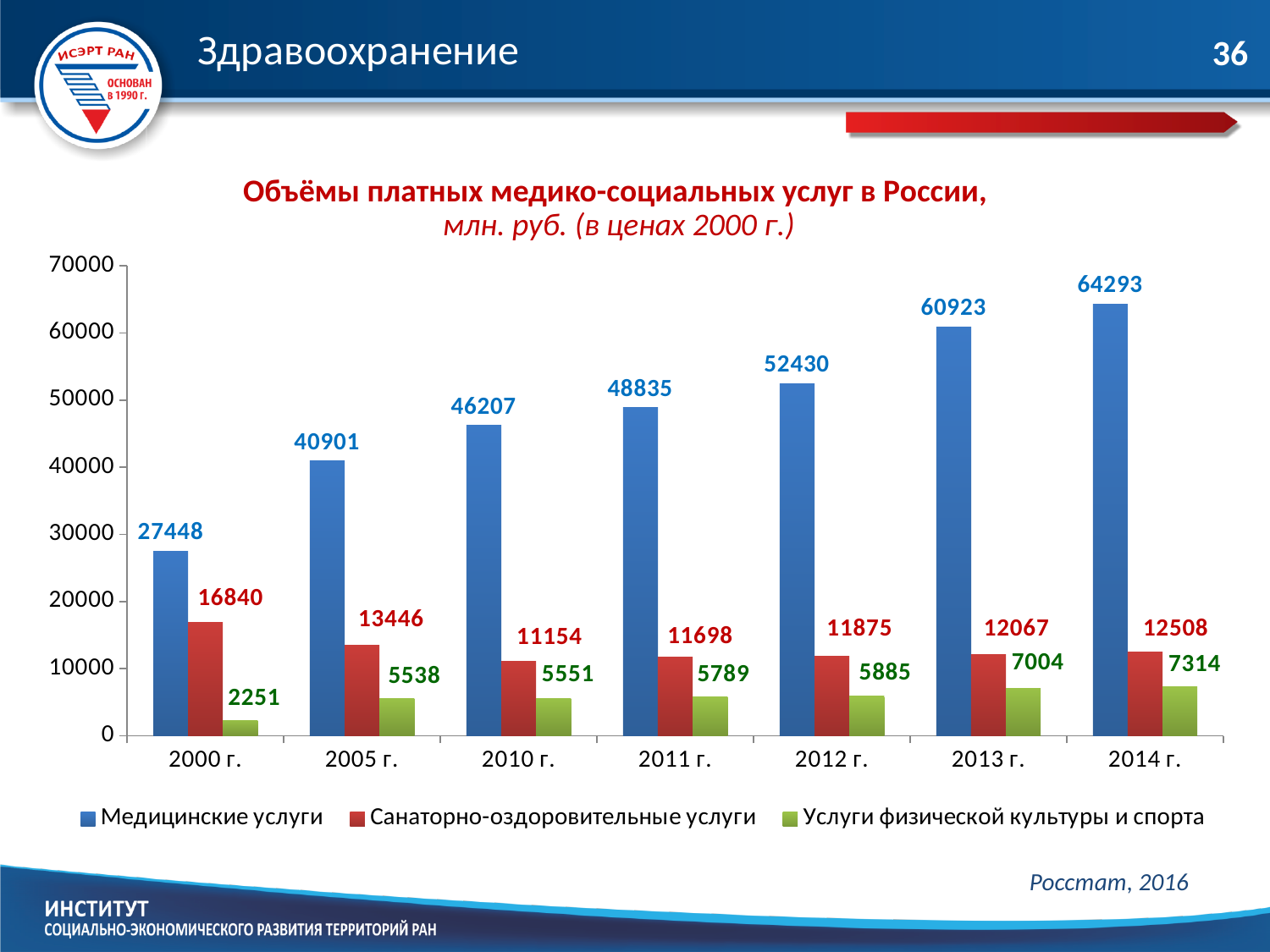
In which year is the value for Медицинские услуги the lowest? 2000 г. What is the value for Услуги физической культуры и спорта in 2013 г.? 7004 Do the values for Услуги физической культуры и спорта rise or fall from 2000 г. to 2014 г.? rise What is the value for Медицинские услуги in 2014 г.? 64293 How many series does the legend list? 3 Which is larger: Санаторно-оздоровительные услуги in 2005 г. or in 2010 г.? 2005 г. Is the value for Медицинские услуги in 2012 г. greater or less than 50000? greater In which year is the value for Санаторно-оздоровительные услуги the highest? 2000 г. What kind of chart is shown on the slide? bar chart What is the value for Санаторно-оздоровительные услуги in 2000 г.? 16840 What is the difference between the Медицинские услуги values for 2014 г. and 2013 г.? 3370 How many years are shown on the x axis? 7